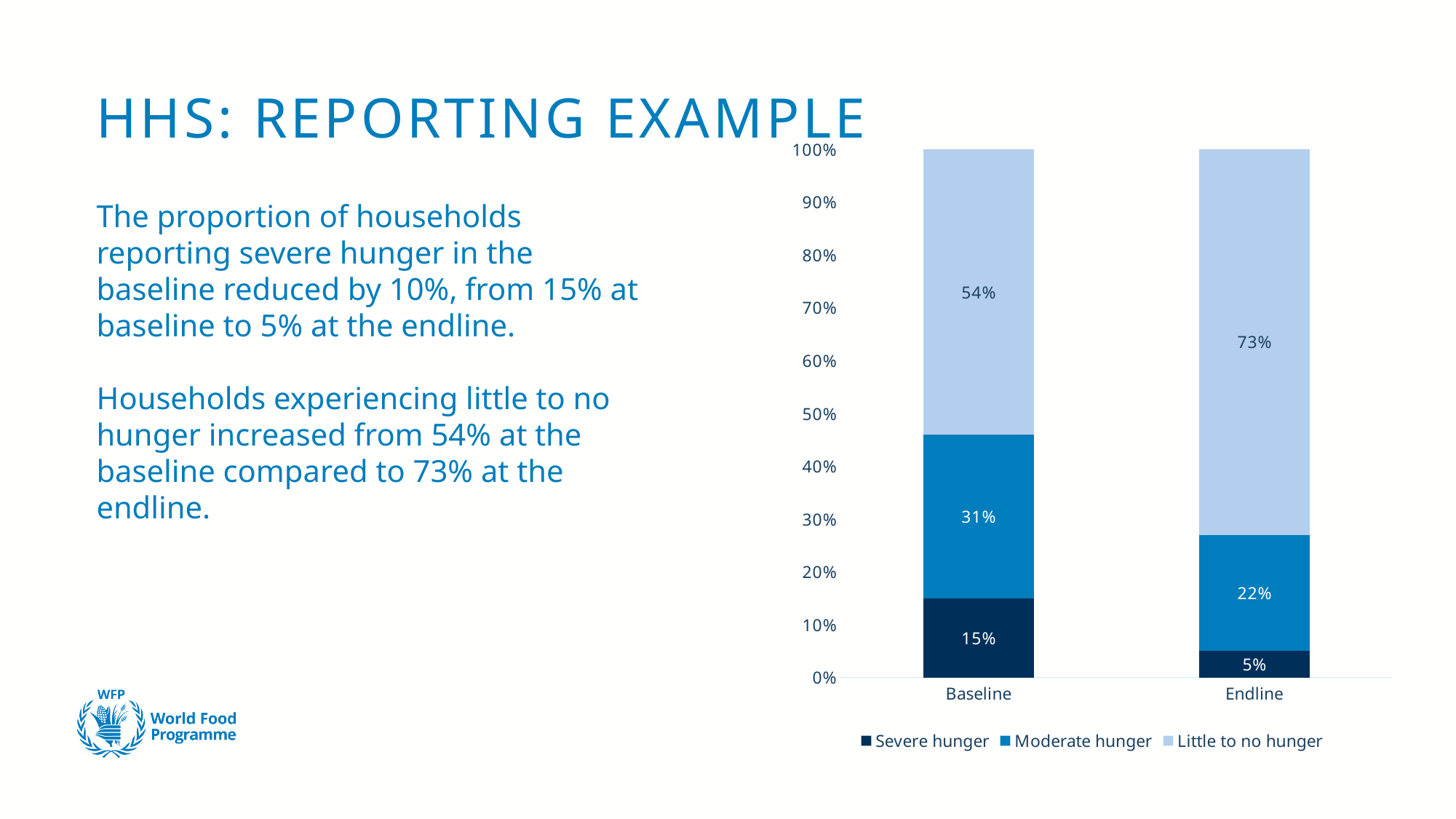
How many categories are shown on the x axis? 2 What kind of chart is shown on the slide? Stacked bar chart Which series is shown in the darkest blue colour? Severe hunger What percentage of households reported severe hunger at Baseline? 15% What is the difference between the Moderate hunger values at Baseline and Endline? 9% What is the total of the stacked bar for Baseline? 100% What percentage of households reported severe hunger at Endline? 5% By how much did the Little to no hunger share change from Baseline to Endline? 19% How many series does the legend list? 3 Which category has the higher value for Little to no hunger, Baseline or Endline? Endline What is the value for Little to no hunger at Baseline? 54% What is the value for Moderate hunger at Endline? 22%